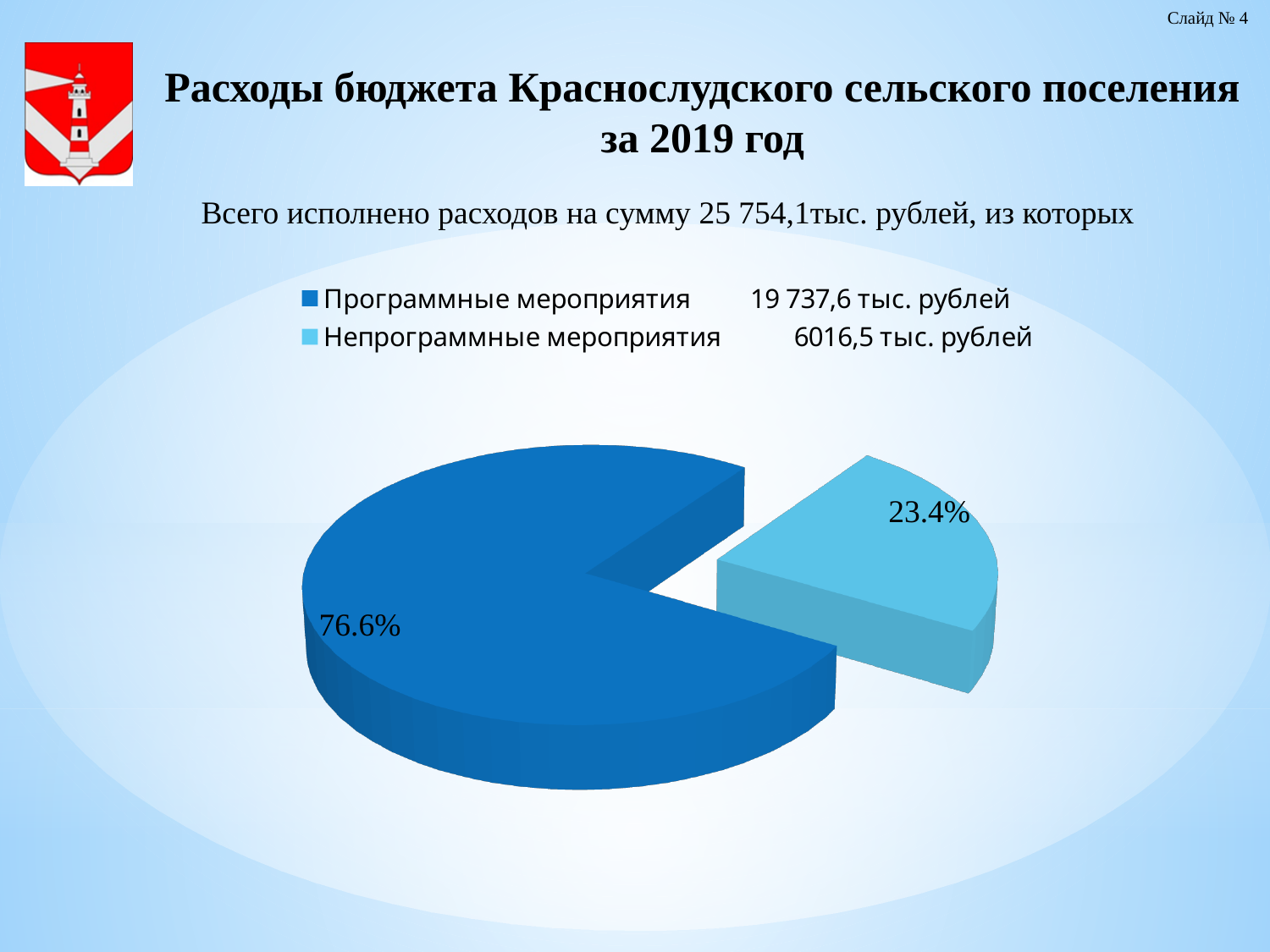
What is the value shown in the legend for Программные мероприятия? 19 737,6 тыс. рублей What kind of chart is shown on the slide? Pie chart What share of the pie does Непрограммные мероприятия take? 23.4% What share of the pie does Программные мероприятия take? 76.6% What is the value shown in the legend for Непрограммные мероприятия? 6016,5 тыс. рублей How many entries does the legend list? 2 How many slices does the pie chart have? 2 What is the difference in percentage points between the two slices of the pie? 53.2 Which category has the largest slice of the pie? Программные мероприятия What is the title of the chart on the slide? Расходы бюджета Краснослудского сельского поселения за 2019 год Which is larger: the share for Программные мероприятия or for Непрограммные мероприятия? Программные мероприятия Which category has the smallest slice of the pie? Непрограммные мероприятия